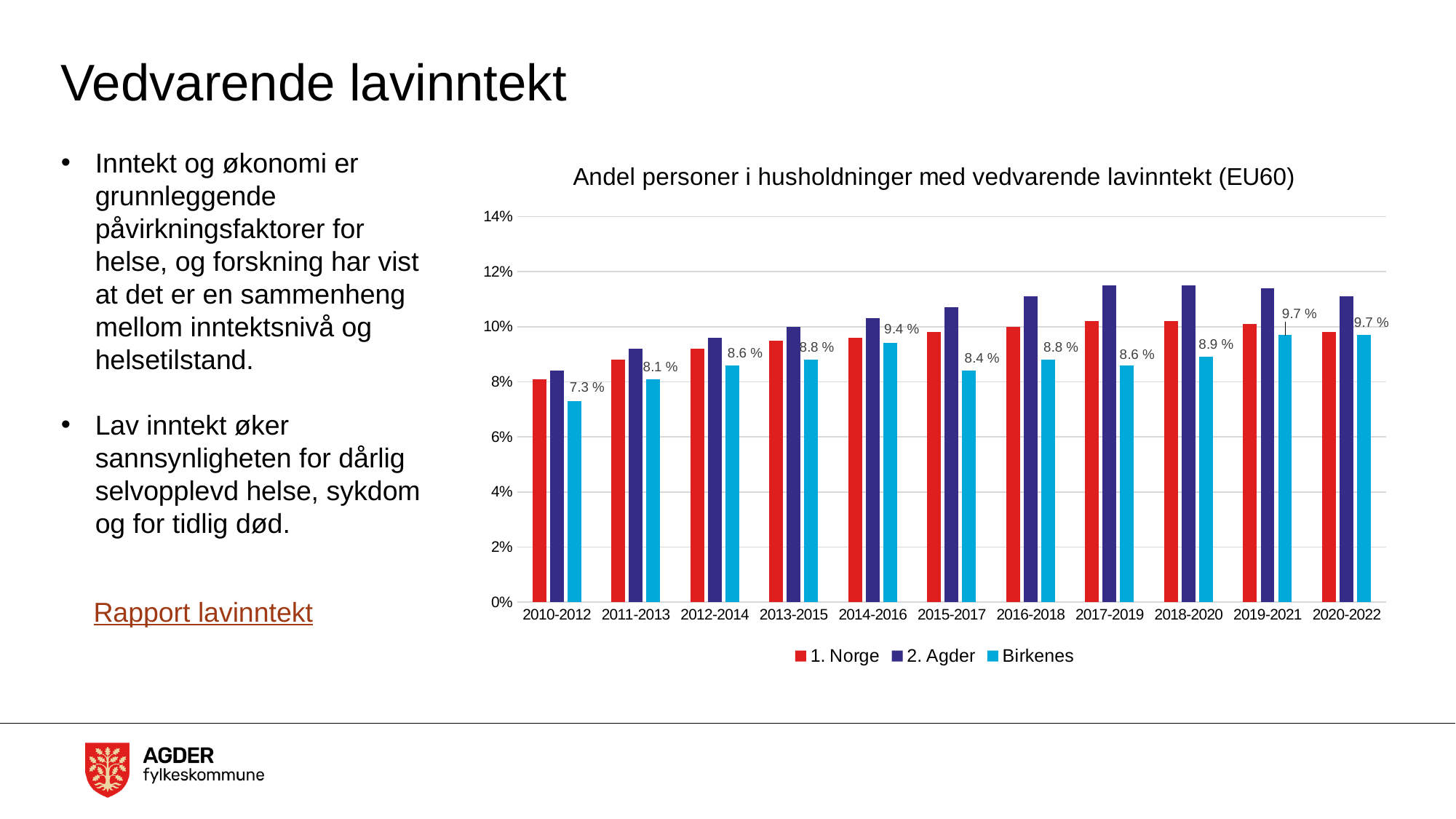
Is the value for 2. Agder in 2017-2019 greater or less than 10%? greater How many series does the legend list? 3 What kind of chart is shown on the slide? bar chart What is the difference between the Birkenes values for 2020-2022 and 2010-2012? 2.4 % Is the value for 1. Norge in 2010-2012 greater or less than 10%? less What is the value for Birkenes in 2014-2016? 9.4 % How many periods are shown on the x axis? 11 What is the value for Birkenes in 2019-2021? 9.7 % In which period is the Birkenes value lowest? 2010-2012 In 2017-2019, which is larger: the value for 1. Norge or for 2. Agder? 2. Agder What is the value for Birkenes in 2010-2012? 7.3 % Does the value for 2. Agder rise or fall from 2010-2012 to 2017-2019? rise